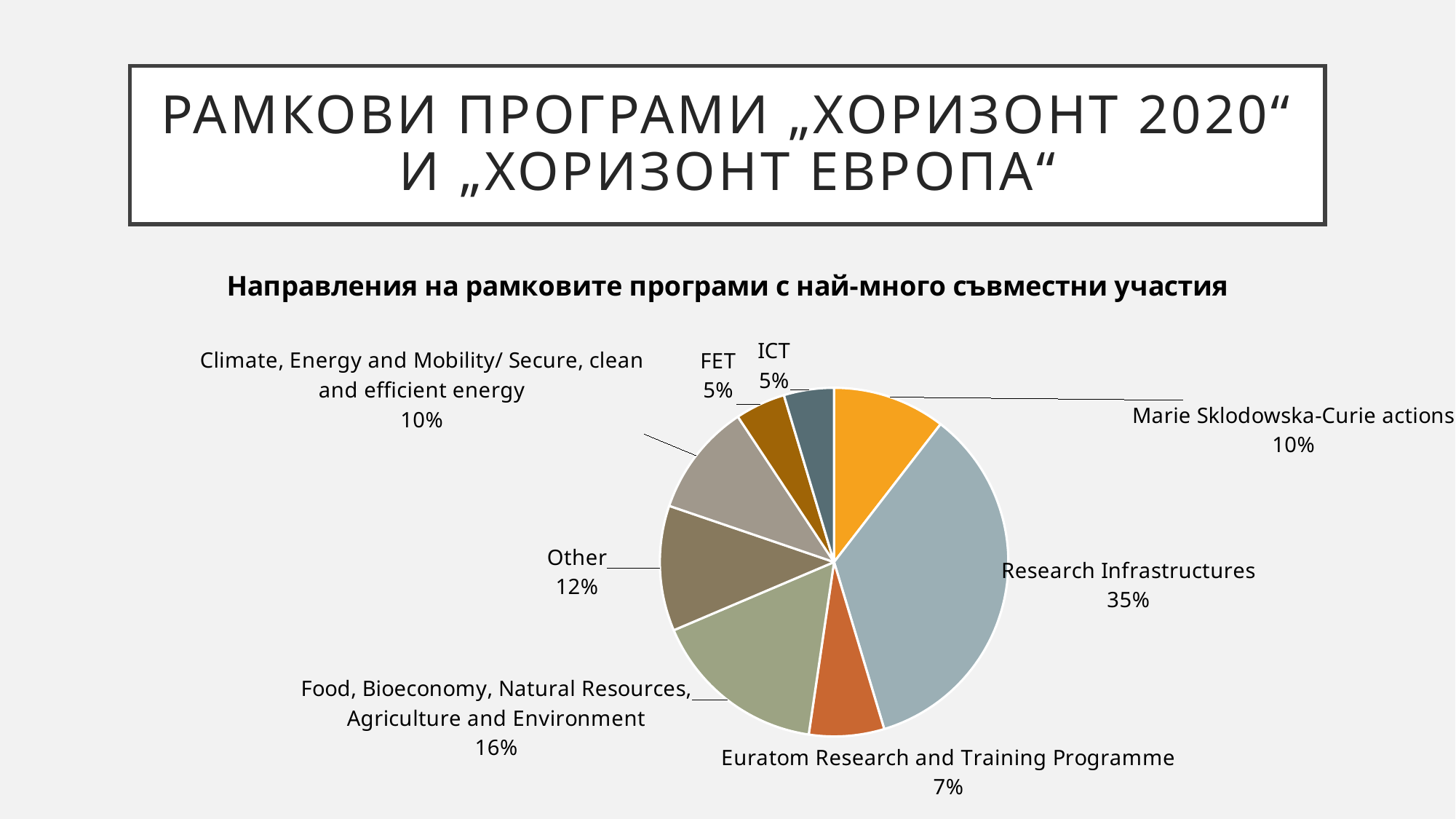
What percentage is shown for the Other slice? 12% What type of chart is shown on the slide? Pie chart Which category has the largest slice of the pie? Research Infrastructures Which is larger, the Other slice or the Euratom Research and Training Programme slice? Other What share of the pie does Research Infrastructures hold? 35% What is the title of the chart? Направления на рамковите програми с най-много съвместни участия What percentage is shown for ICT? 5% How many slices does the pie chart have? 8 What is the difference in percentage points between Research Infrastructures and Food, Bioeconomy, Natural Resources, Agriculture and Environment? 19 What percentage is shown for Food, Bioeconomy, Natural Resources, Agriculture and Environment? 16% What percentage is shown for Euratom Research and Training Programme? 7% What percentage is shown for Marie Sklodowska-Curie actions? 10%